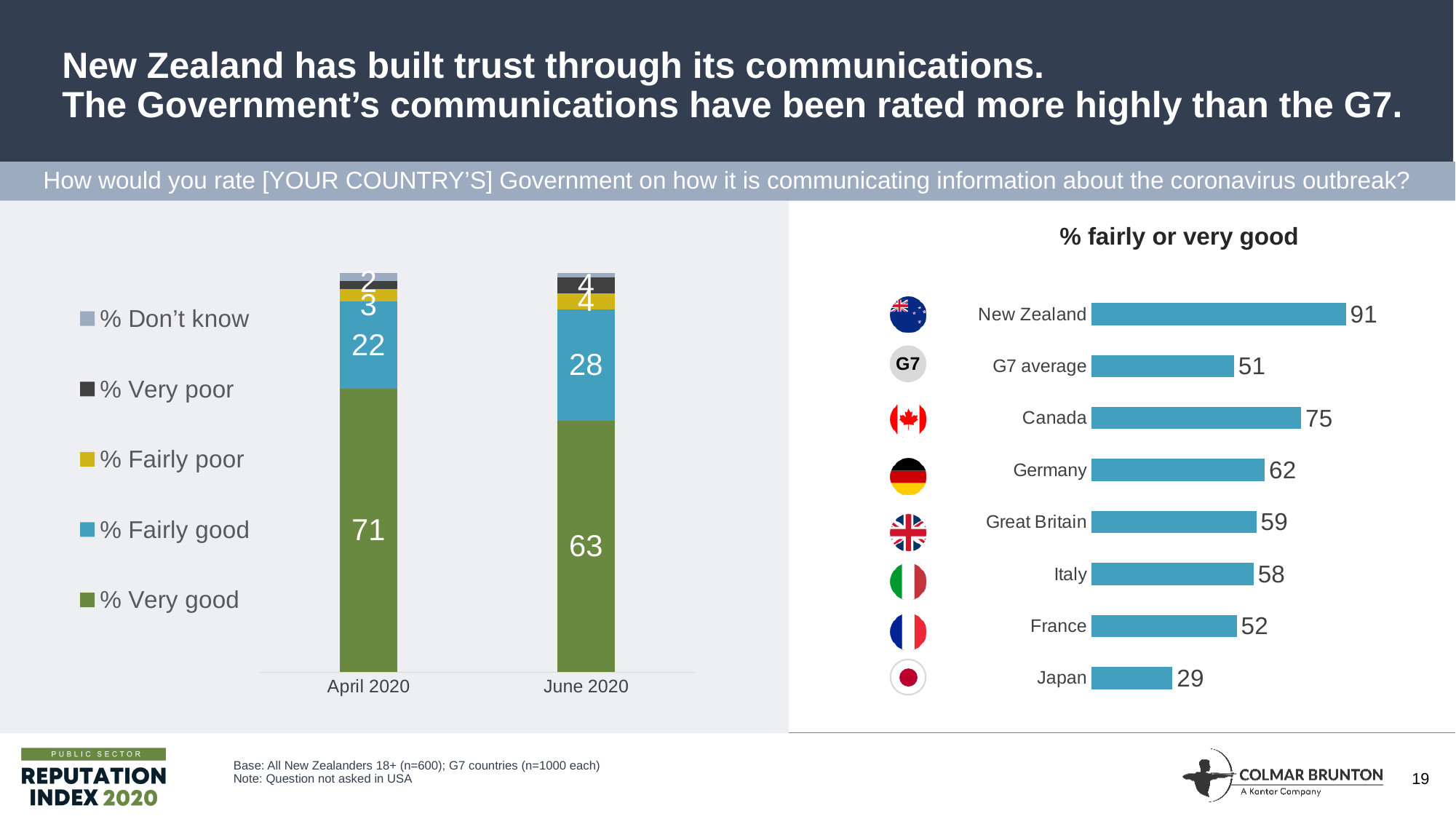
How many bars are shown in the '% fairly or very good' chart? 8 In the '% fairly or very good' chart, which country has the lowest value? Japan In the '% fairly or very good' chart, what is the value for Japan? 29 In the '% fairly or very good' chart, which country has the highest value? New Zealand In the stacked bar chart on the left, what is the '% Fairly good' value for June 2020? 28 In the '% fairly or very good' chart, what is the value for New Zealand? 91 In the '% fairly or very good' chart, what is the difference between New Zealand and the G7 average? 40 In the stacked bar chart on the left, how many series does the legend list? 5 What kind of chart is the chart on the left of the slide? Stacked bar chart In the stacked bar chart on the left, what is the '% Very good' value for April 2020? 71 In the '% fairly or very good' chart, what is the value for the G7 average? 51 In the '% fairly or very good' chart, which is larger, Canada or Germany? Canada